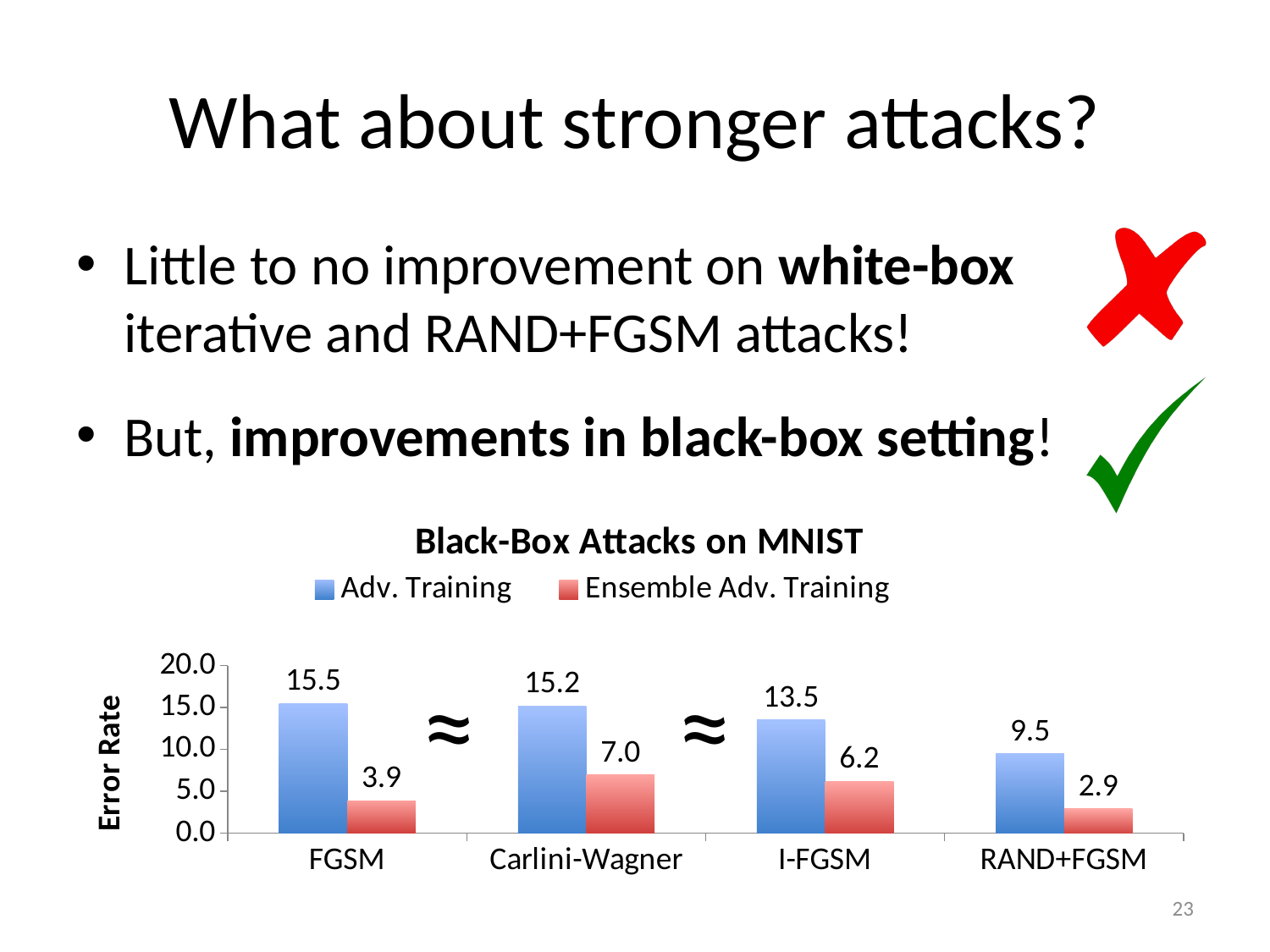
What is the title of the chart? Black-Box Attacks on MNIST How many series does the legend list? 2 What is the error rate for Ensemble Adv. Training on Carlini-Wagner? 7.0 Which attack has the lowest error rate for Ensemble Adv. Training? RAND+FGSM Which is larger: the Adv. Training error rate on RAND+FGSM or the Ensemble Adv. Training error rate on Carlini-Wagner? Adv. Training on RAND+FGSM How many attack categories are shown on the x axis? 4 What is the difference between the Adv. Training and Ensemble Adv. Training error rates on I-FGSM? 7.3 What is the error rate for Adv. Training on FGSM? 15.5 Which attack has the highest error rate for Adv. Training? FGSM What is the error rate for Ensemble Adv. Training on RAND+FGSM? 2.9 Is the Adv. Training error rate on I-FGSM greater or less than 10.0? greater What kind of chart is shown on the slide? Bar chart